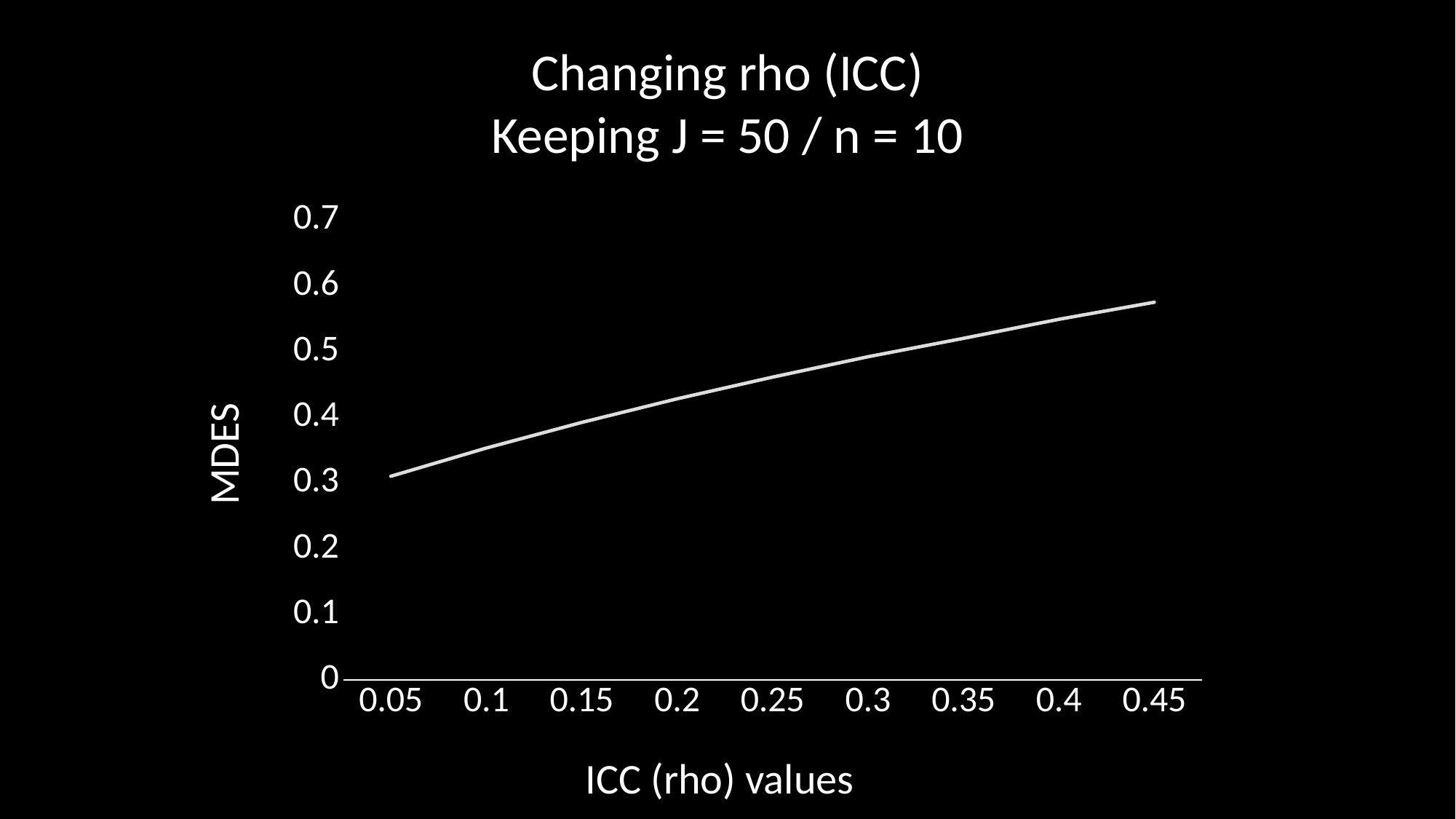
At which ICC (rho) value is MDES lowest? 0.05 Is the MDES value at ICC 0.45 greater or less than 0.5? greater How many ICC (rho) values are marked along the x axis? 9 What is the title of the chart? Changing rho (ICC) Keeping J = 50 / n = 10 What kind of chart is shown on the slide? line chart Which has the larger MDES value: ICC 0.1 or ICC 0.4? ICC 0.4 Is the MDES value at ICC 0.25 greater or less than 0.4? greater Does MDES rise or fall as the ICC (rho) value increases? rises At which ICC (rho) value is MDES highest? 0.45 Is the MDES value at ICC 0.35 greater or less than 0.6? less What is the label of the y axis? MDES